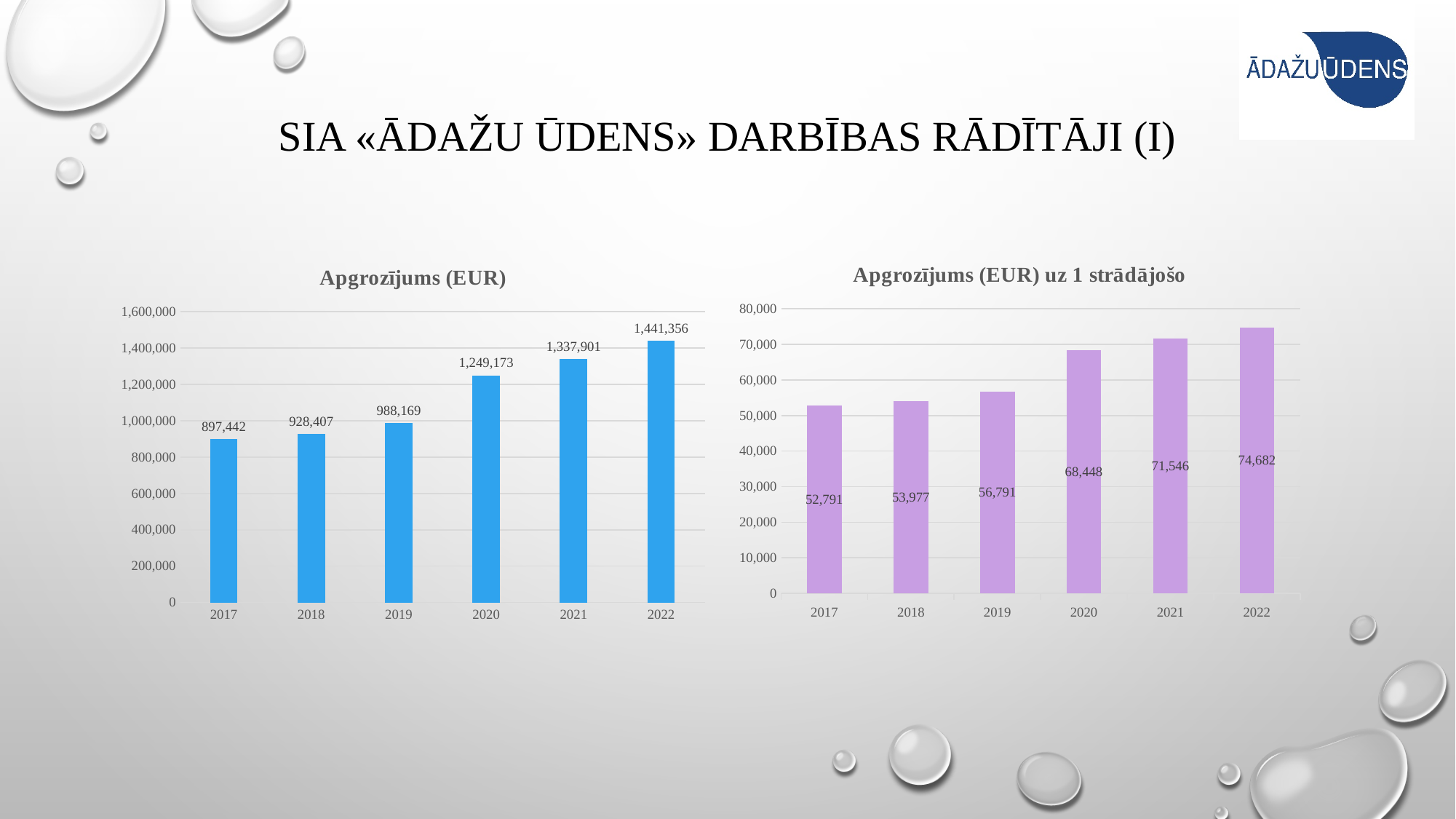
In the 'Apgrozījums (EUR)' chart, what is the difference between the 2022 and 2017 values? 543,914 In the 'Apgrozījums (EUR) uz 1 strādājošo' chart, which year has the lowest value? 2017 In the 'Apgrozījums (EUR) uz 1 strādājošo' chart, what is the difference between the 2022 and 2017 values? 21,891 What kind of chart is the 'Apgrozījums (EUR) uz 1 strādājošo' chart? bar chart In the 'Apgrozījums (EUR)' chart, which is larger, the value for 2019 or the value for 2020? 2020 In the 'Apgrozījums (EUR) uz 1 strādājošo' chart, is the value for 2021 greater or less than 70,000? greater In the 'Apgrozījums (EUR)' chart, what is the value for 2020? 1,249,173 In the 'Apgrozījums (EUR)' chart, do the values rise or fall from 2017 to 2022? rise What colour are the bars in the 'Apgrozījums (EUR) uz 1 strādājošo' chart? purple In the 'Apgrozījums (EUR) uz 1 strādājošo' chart, what is the value for 2019? 56,791 In the 'Apgrozījums (EUR)' chart, which year has the highest value? 2022 How many years are shown in the 'Apgrozījums (EUR)' chart? 6